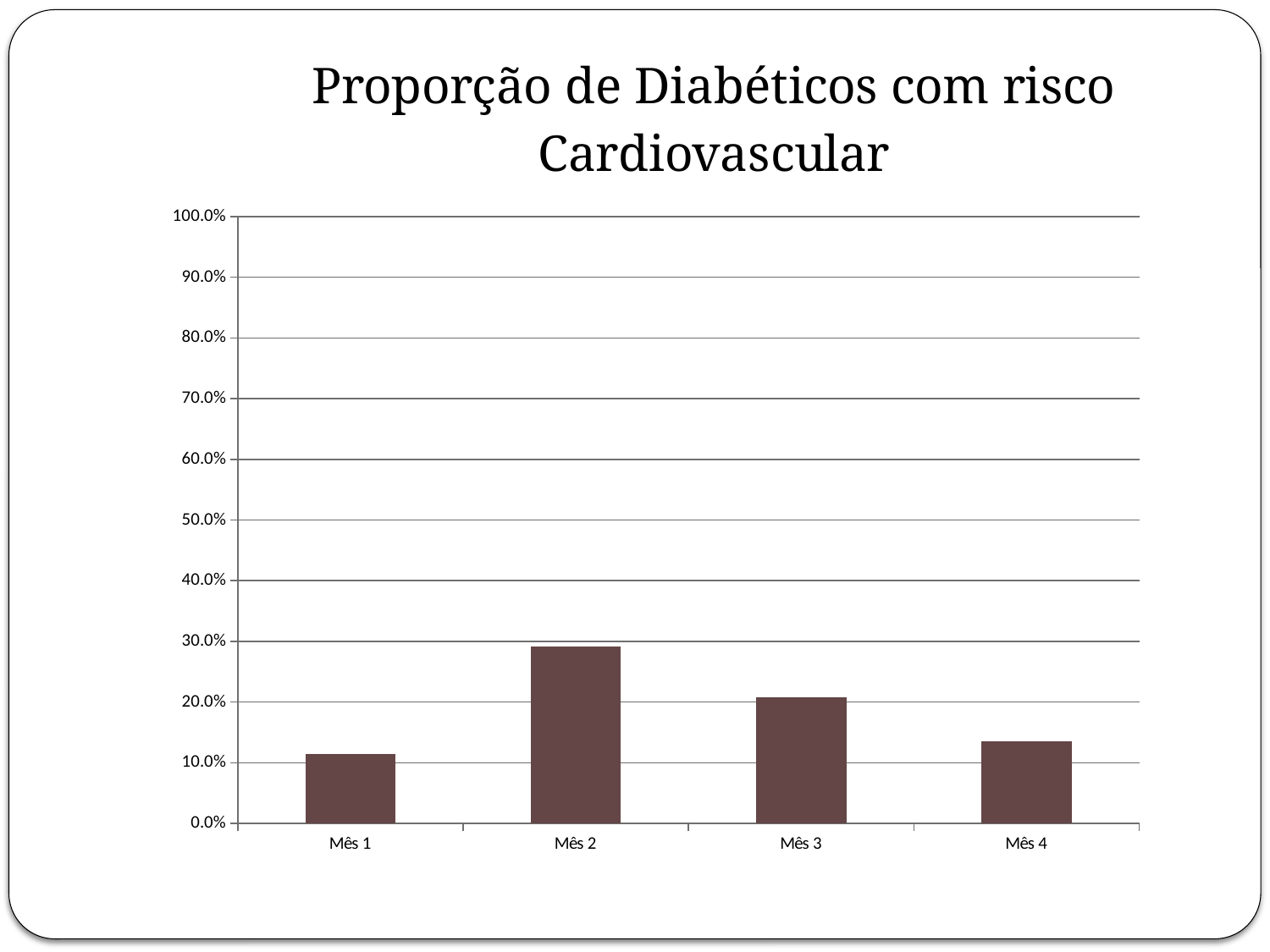
Which month has the highest proportion of diabetics with cardiovascular risk? Mês 2 Is the value for Mês 1 greater or less than 20.0%? less From Mês 2 to Mês 4, do the values rise or fall? fall How many categories (months) are shown on the x axis? 4 Is the value for Mês 2 greater or less than 20.0%? greater What kind of chart is shown on the slide? bar chart Which is larger, the value for Mês 3 or the value for Mês 4? Mês 3 Is the value for Mês 3 greater or less than 30.0%? less What is the title of the chart? Proporção de Diabéticos com risco Cardiovascular Which is larger, the value for Mês 2 or the value for Mês 3? Mês 2 Which month has the lowest proportion of diabetics with cardiovascular risk? Mês 1